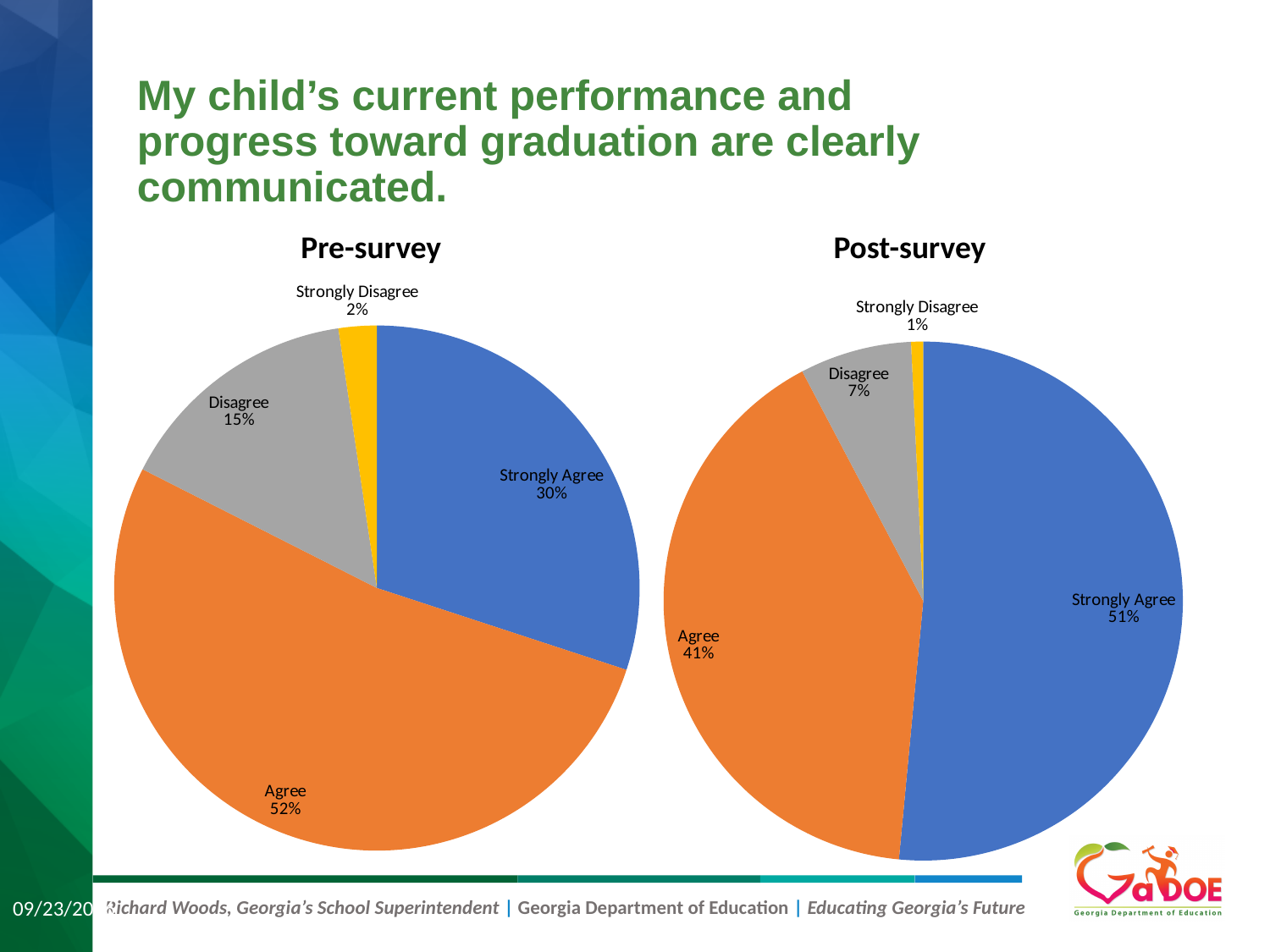
In the Post-survey chart, what is the difference between the Agree and Disagree shares? 34 percentage points How many response categories are shown in the Pre-survey chart? 4 In the Pre-survey chart, which response has the largest share? Agree In the Post-survey chart, what percentage of respondents chose Strongly Disagree? 1% In the Pre-survey chart, what percentage of respondents chose Disagree? 15% What type of chart is used for the Post-survey data? Pie chart In the Pre-survey chart, what colour is the Agree slice? Orange Which is larger: the Disagree share in the Pre-survey chart or the Disagree share in the Post-survey chart? Pre-survey What is the difference between the Strongly Agree share in the Post-survey chart and the Strongly Agree share in the Pre-survey chart? 21 percentage points In the Pre-survey chart, what percentage of respondents chose Agree? 52% In the Post-survey chart, what percentage of respondents chose Strongly Agree? 51% In the Post-survey chart, which response has the smallest share? Strongly Disagree